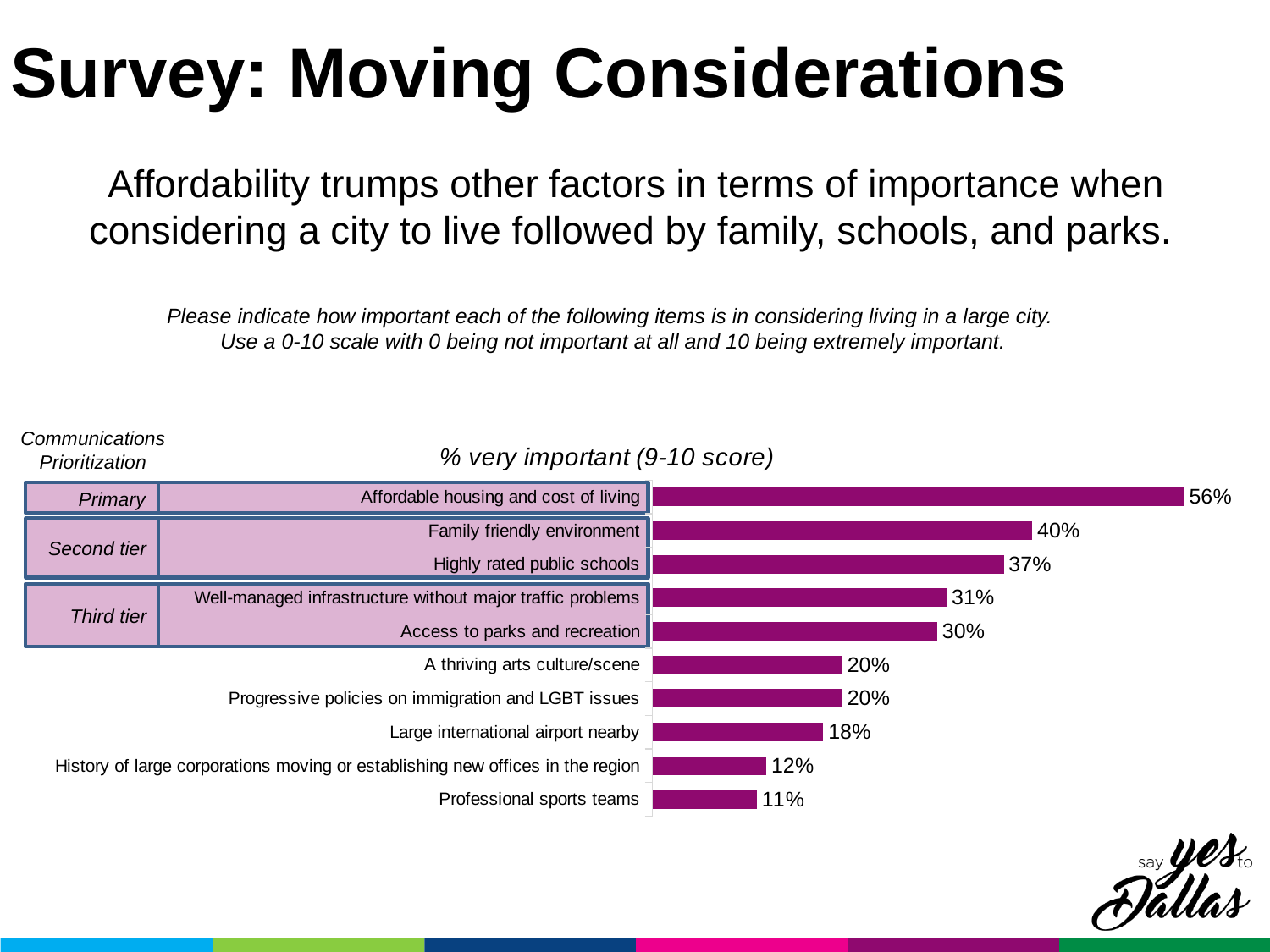
What is the difference between 'Affordable housing and cost of living' and 'Professional sports teams'? 45% What percentage rated 'Affordable housing and cost of living' as very important? 56% What kind of chart is shown on the slide? Bar chart What is the difference between 'Family friendly environment' and 'Highly rated public schools'? 3% What is the value for 'Highly rated public schools'? 37% What is the title of the chart? % very important (9-10 score) How many items are shown in the chart? 10 Which items are grouped under 'Second tier' in the Communications Prioritization? Family friendly environment; Highly rated public schools What is the value for 'Large international airport nearby'? 18% Which is larger: 'Well-managed infrastructure without major traffic problems' or 'Access to parks and recreation'? Well-managed infrastructure without major traffic problems Which item has the highest percentage of very important ratings? Affordable housing and cost of living Which item has the lowest percentage of very important ratings? Professional sports teams